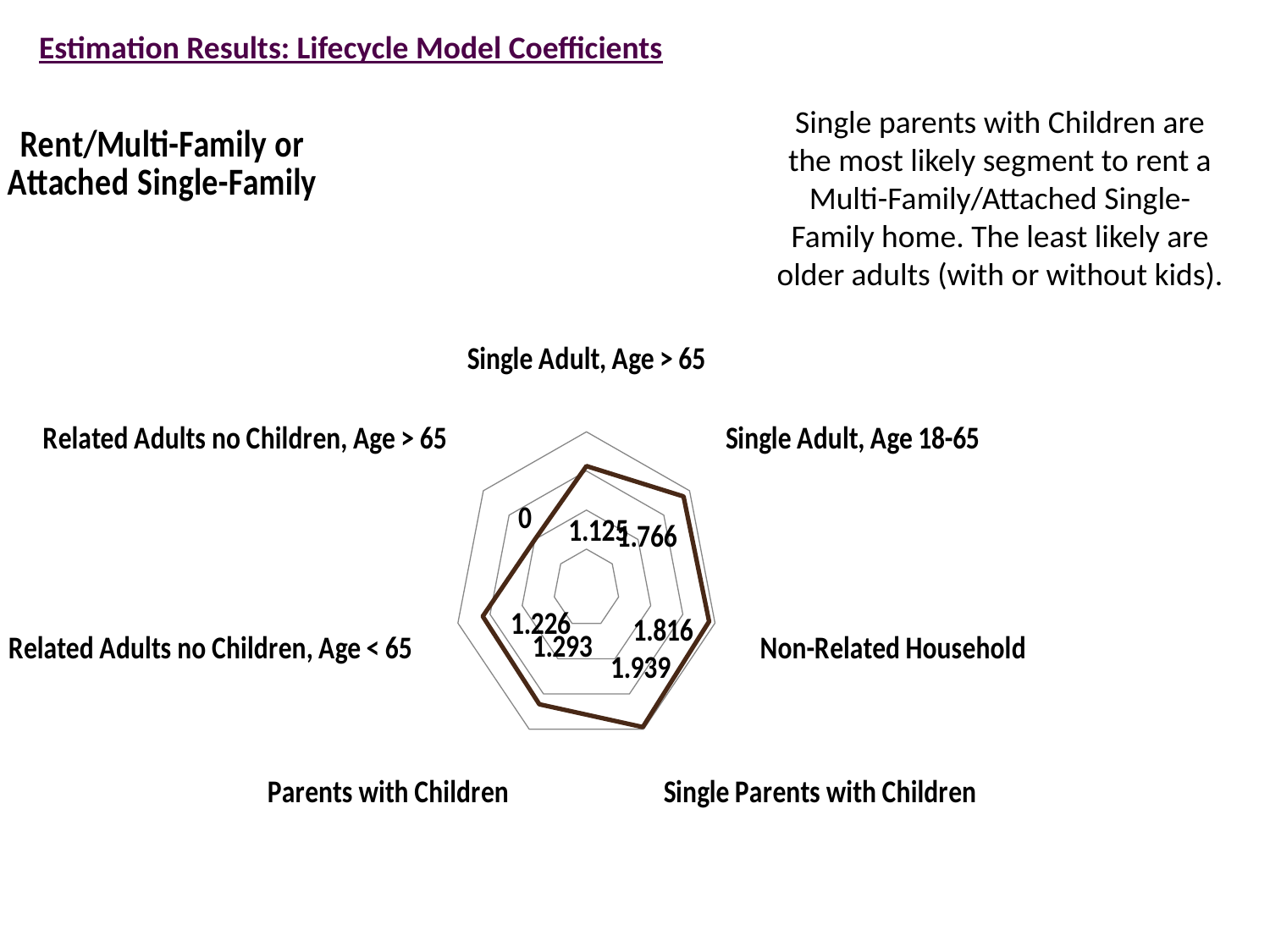
What is the value for Single Adult, Age > 65? 1.125 How many categories are plotted on the chart? 7 What is the value for Parents with Children? 1.293 What type of chart is shown on the slide? Radar chart Which category has the highest value? Single Parents with Children What is the value for Single Adult, Age 18-65? 1.766 Which category has the lowest value? Related Adults no Children, Age > 65 What is the value for Non-Related Household? 1.816 What is the value for Single Parents with Children? 1.939 What is the difference between the values for Single Parents with Children and Non-Related Household? 0.123 What is the value for Related Adults no Children, Age < 65? 1.226 What is the title of the chart? Rent/Multi-Family or Attached Single-Family